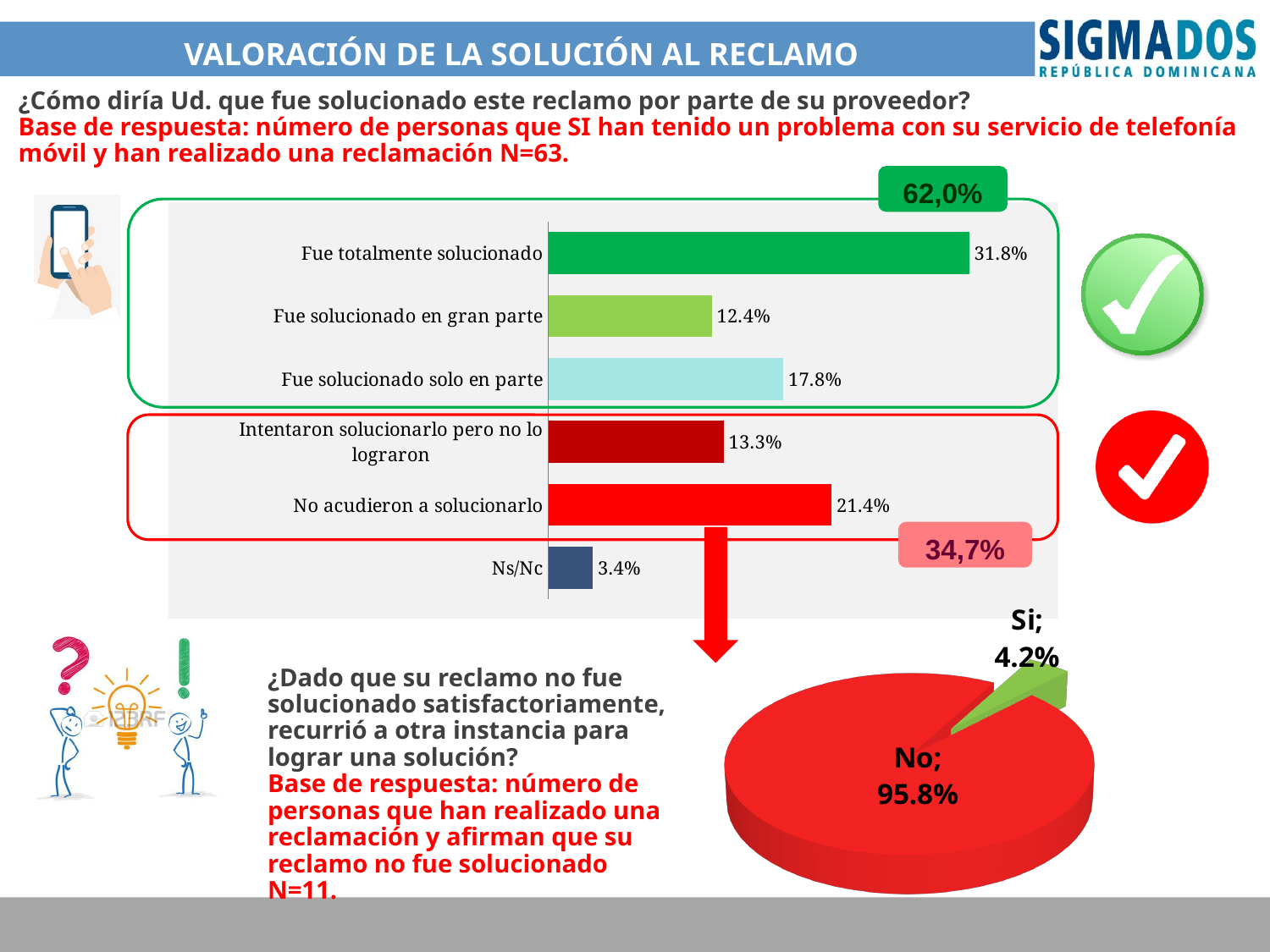
In the pie chart at the bottom, what share is labelled "No"? 95.8% How many categories does the bar chart show? 6 In the bar chart, what is the value for "Fue totalmente solucionado"? 31.8% In the bar chart, which category has the highest value? Fue totalmente solucionado In the bar chart, what is the value for "Ns/Nc"? 3.4% In the bar chart, what is the difference between "Fue totalmente solucionado" and "No acudieron a solucionarlo"? 10.4% In the pie chart at the bottom, what share is labelled "Si"? 4.2% What kind of chart is the bottom chart on the slide? Pie chart What kind of chart is the top chart on the slide? Bar chart In the bar chart, what is the value for "No acudieron a solucionarlo"? 21.4% In the bar chart, which category has the lowest value? Ns/Nc In the bar chart, which is larger: "Fue solucionado en gran parte" or "Fue solucionado solo en parte"? Fue solucionado solo en parte